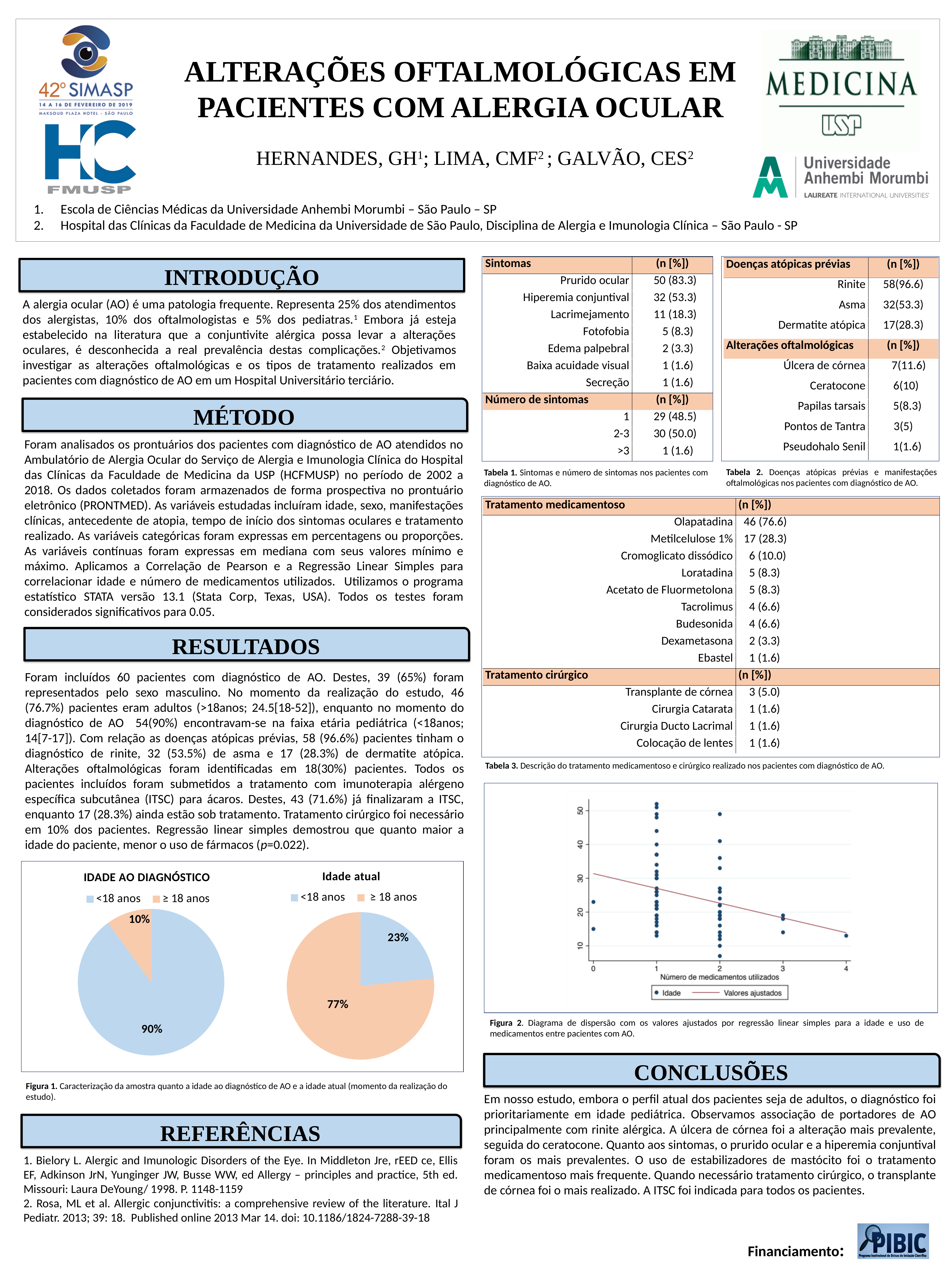
In the scatter plot (Figura 2), does the fitted line (Valores ajustados) rise or fall as the number of medications increases? Fall In the IDADE AO DIAGNÓSTICO pie chart, what is the difference in percentage points between the <18 anos and ≥ 18 anos slices? 80 percentage points In the Idade atual pie chart, which category has the largest slice? ≥ 18 anos In the IDADE AO DIAGNÓSTICO pie chart, what share is shown for ≥ 18 anos? 10% What type of chart is the IDADE AO DIAGNÓSTICO chart? Pie chart In the IDADE AO DIAGNÓSTICO pie chart, which category has the smallest slice? ≥ 18 anos In the Idade atual pie chart, what share is shown for <18 anos? 23% In the IDADE AO DIAGNÓSTICO pie chart, what share is shown for <18 anos? 90% How many slices does the Idade atual pie chart have? 2 In the scatter plot (Figura 2), how many entries does the legend list? 2 Is the <18 anos share larger in the IDADE AO DIAGNÓSTICO pie chart or in the Idade atual pie chart? IDADE AO DIAGNÓSTICO In the Idade atual pie chart, what share is shown for ≥ 18 anos? 77%